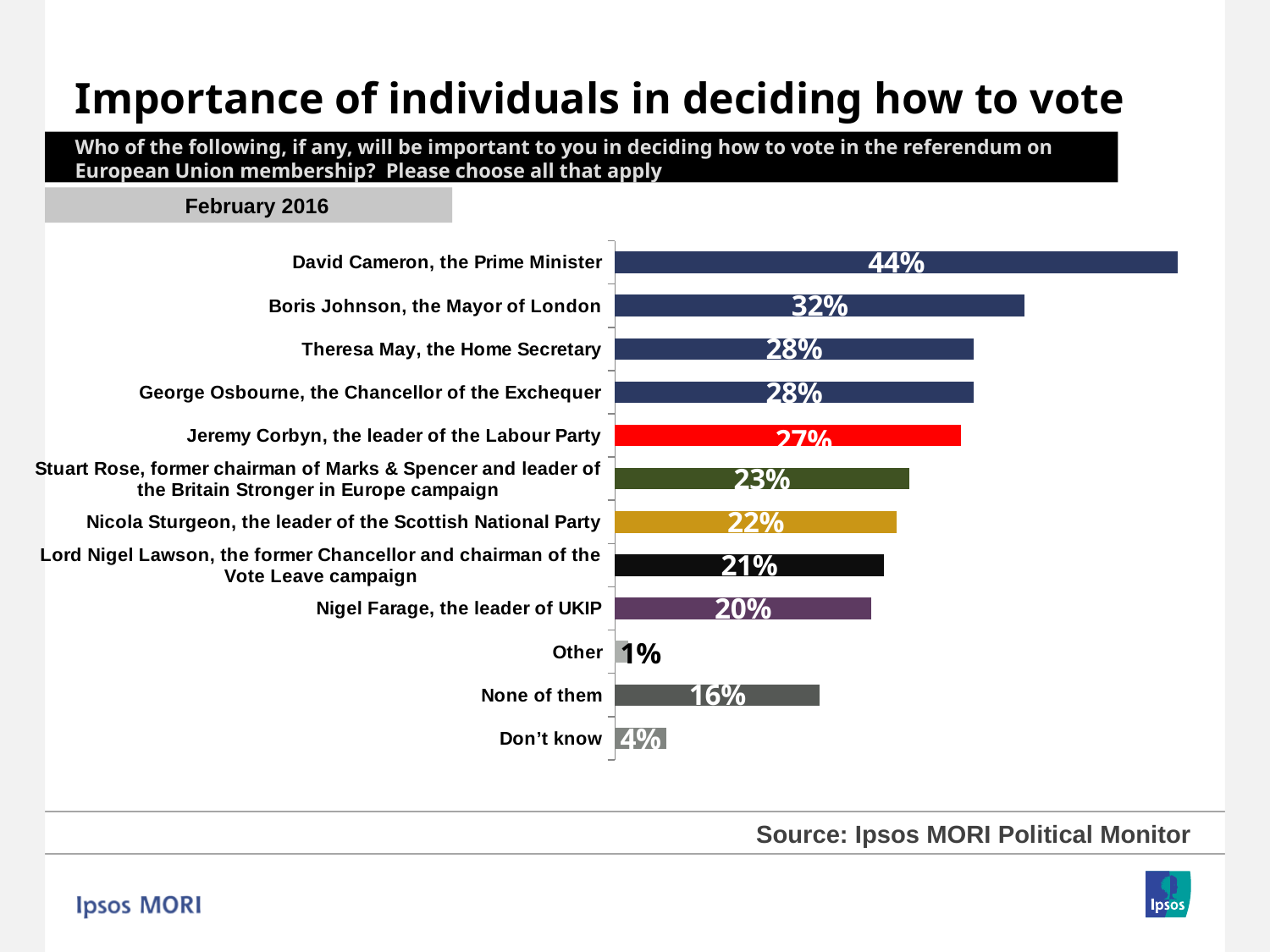
What colour is the bar for Jeremy Corbyn, the leader of the Labour Party? Red How many categories are shown on the chart? 12 Which individual has the highest percentage on the chart? David Cameron, the Prime Minister Which has a higher value: Nicola Sturgeon, the leader of the Scottish National Party, or Nigel Farage, the leader of UKIP? Nicola Sturgeon, the leader of the Scottish National Party What value is shown for Jeremy Corbyn, the leader of the Labour Party? 27% What value is shown for 'None of them'? 16% What is the difference in percentage points between David Cameron and Boris Johnson? 12 What percentage of respondents said David Cameron, the Prime Minister, will be important in deciding how to vote? 44% What value is shown for Boris Johnson, the Mayor of London? 32% What kind of chart is shown on the slide? Bar chart Which category has the lowest percentage on the chart? Other What value is shown for Nigel Farage, the leader of UKIP? 20%